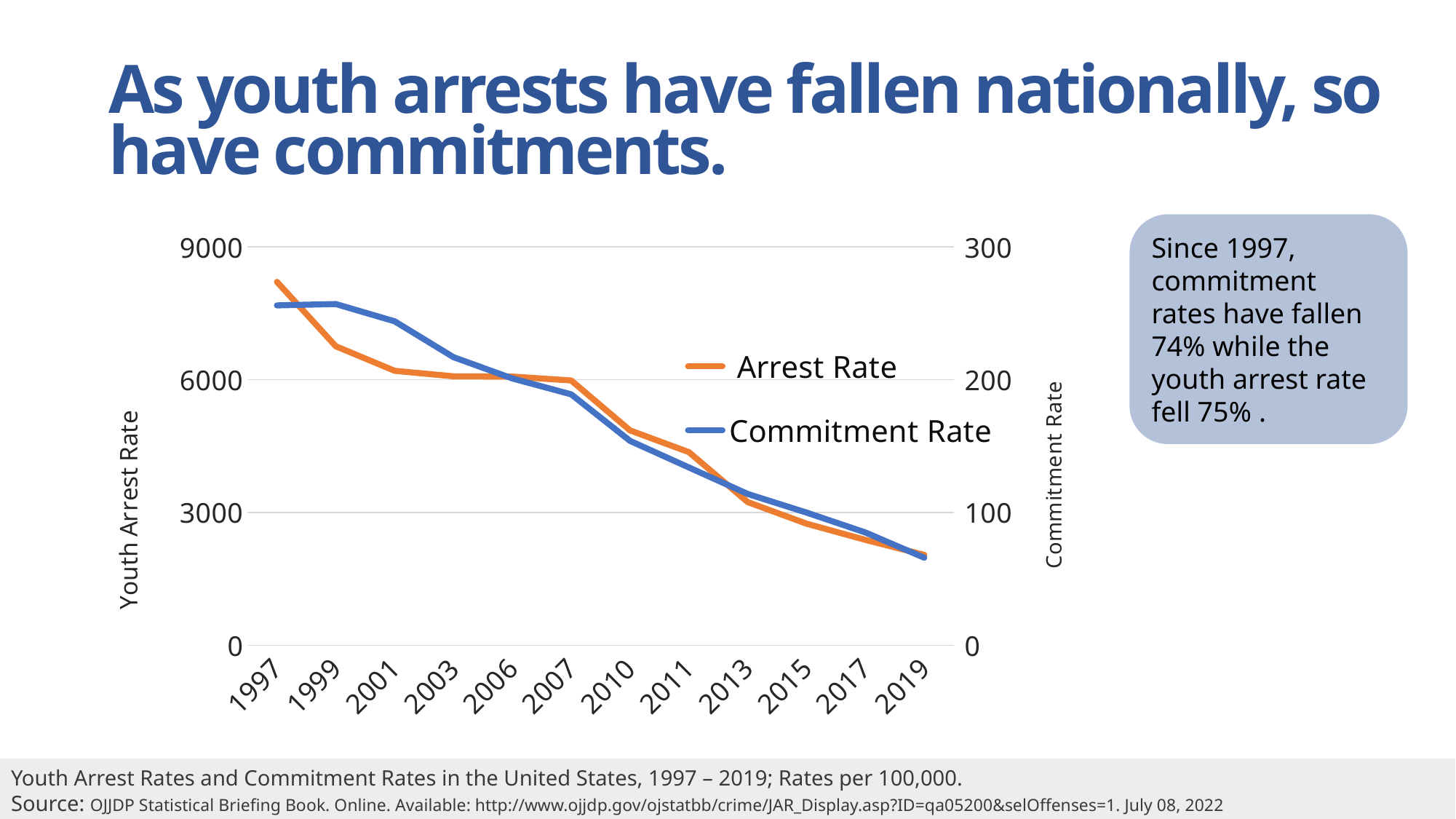
Is the Arrest Rate value for 1997 greater or less than 6000? greater How many series does the chart's legend list? 2 Do the Arrest Rate values rise or fall from 1997 to 2019? fall Do the Commitment Rate values rise or fall from 1997 to 2019? fall Is the Commitment Rate value for 2019 greater or less than 100? less How many years are plotted along the x axis of the chart? 12 What is the title of the left vertical axis of the chart? Youth Arrest Rate In which year is the Arrest Rate lowest? 2019 In which year is the Arrest Rate highest? 1997 What kind of chart is shown on the slide? line chart Is the Arrest Rate value for 2019 greater or less than 3000? less